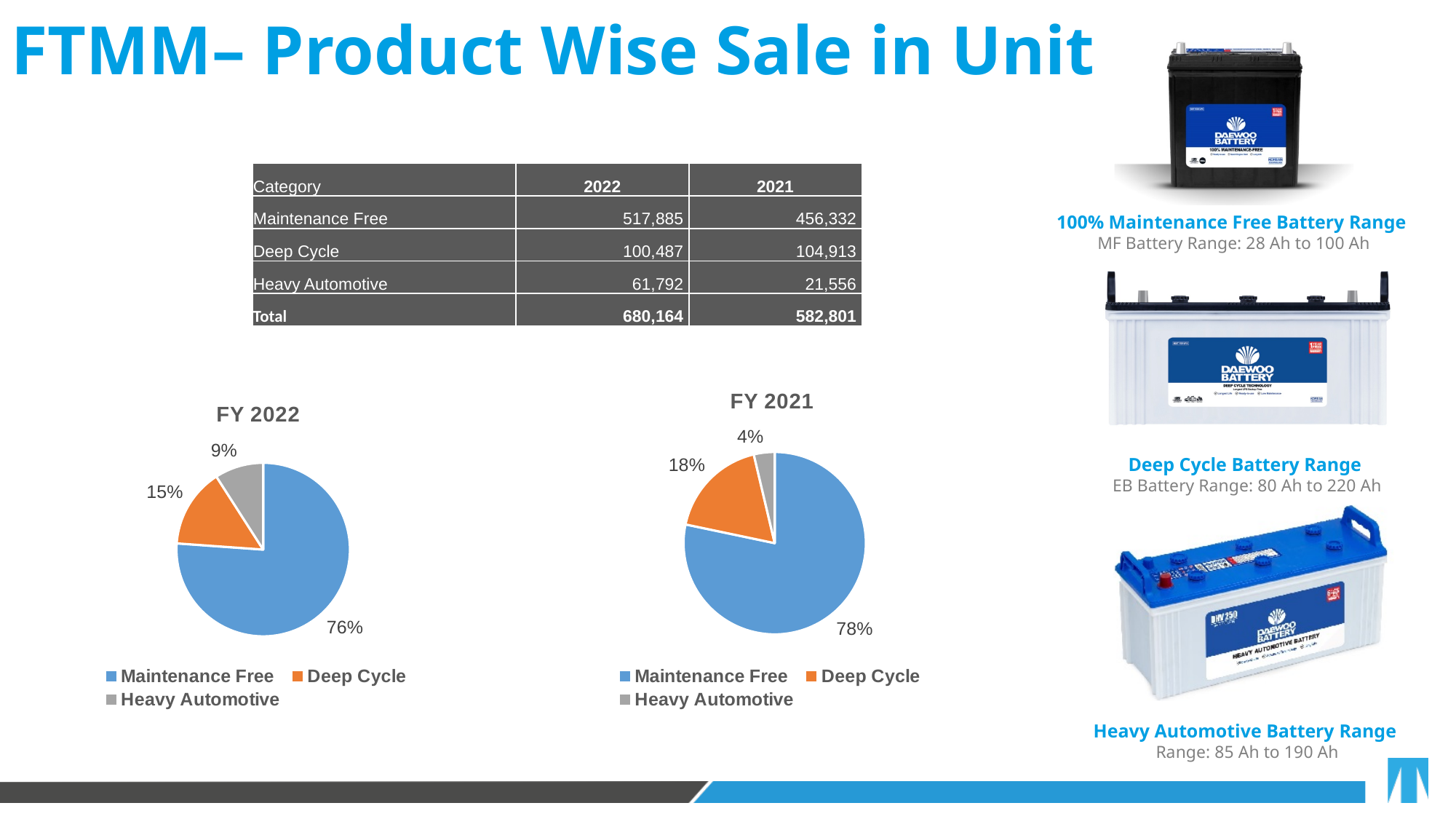
In the FY 2021 pie chart, what share does Maintenance Free have? 78% In the FY 2021 pie chart, which is larger, the Deep Cycle slice or the Heavy Automotive slice? Deep Cycle In the FY 2022 pie chart, what share does Heavy Automotive have? 9% In the FY 2021 pie chart, what share does Heavy Automotive have? 4% What type of chart is the FY 2022 chart? Pie chart How many categories does the legend of the FY 2021 pie chart list? 3 In the FY 2021 pie chart, which category has the smallest slice? Heavy Automotive In the FY 2022 pie chart, which category has the largest slice? Maintenance Free In the FY 2022 pie chart, what is the difference in percentage points between the Deep Cycle and Heavy Automotive slices? 6